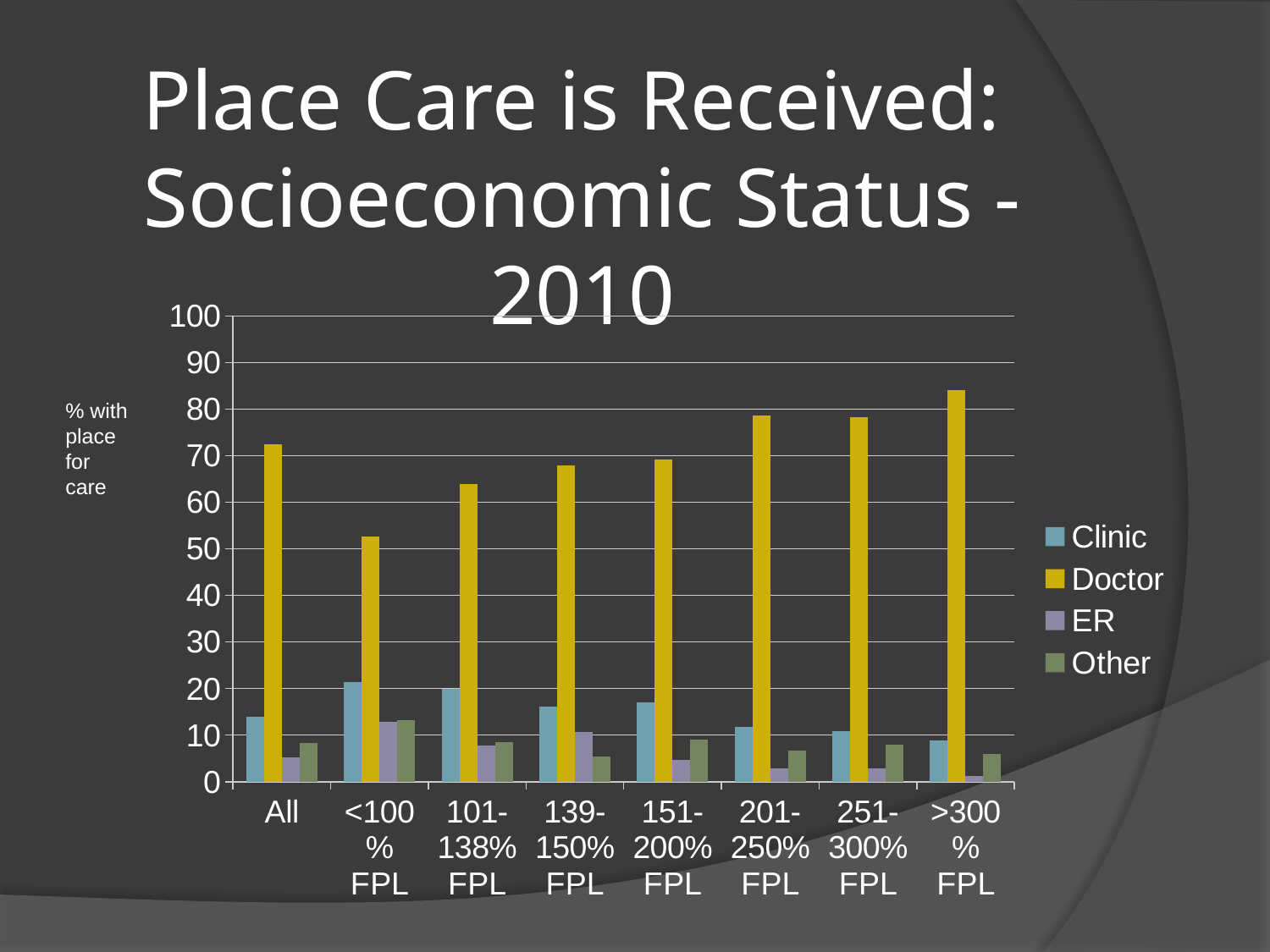
Which category has the highest Doctor value? >300% FPL How many series does the legend list? 4 Which is larger for the All category, the Clinic value or the ER value? Clinic Do the Doctor values generally rise or fall from <100% FPL to >300% FPL? rise How many income categories are shown on the x axis? 8 Which category has the highest ER value? <100% FPL What kind of chart is shown on the slide? bar chart Which category has the lowest Doctor value? <100% FPL Is the ER value for All greater or less than 10? less Which category has the lowest Clinic value? >300% FPL Is the Doctor value for >300% FPL greater or less than 80? greater Is the Doctor value for <100% FPL greater or less than 50? greater